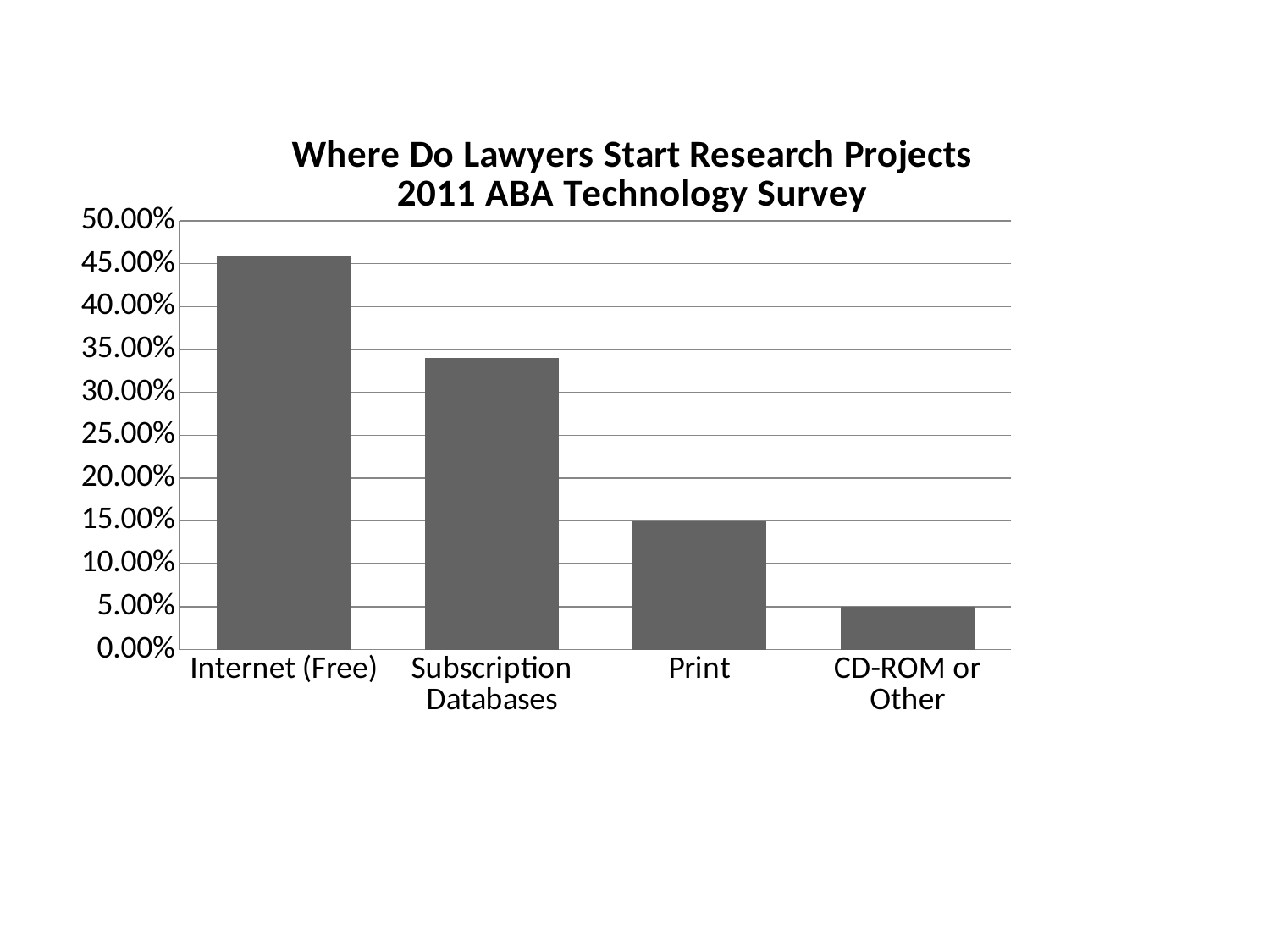
What is the value for Print? 15.00% Which category has the lowest value? CD-ROM or Other Do the values rise or fall from left to right along the x axis? fall What kind of chart is shown on the slide? bar chart Is the value for Subscription Databases greater or less than 35.00%? less Which category has the highest value? Internet (Free) Is the value for Internet (Free) greater or less than 45.00%? greater How many categories are shown on the x axis? 4 Which is larger, the value for Subscription Databases or the value for Print? Subscription Databases What is the difference between the values for Print and CD-ROM or Other? 10.00% What is the value for CD-ROM or Other? 5.00% What survey is named in the chart title? 2011 ABA Technology Survey